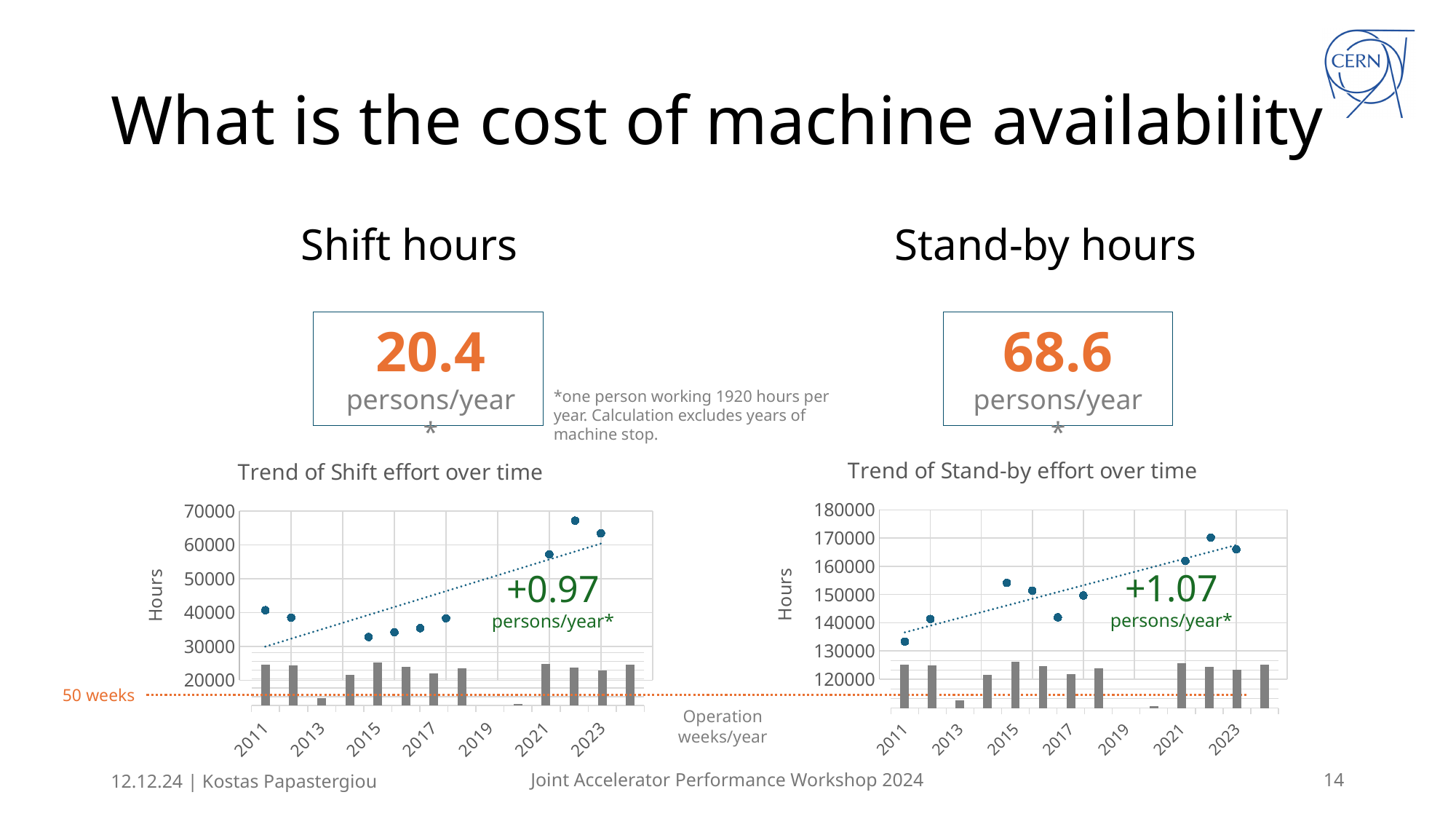
On the 'Trend of Shift effort over time' chart, do the plotted hours generally rise or fall from 2011 to 2023? rise On the 'Trend of Stand-by effort over time' chart, which year has the highest plotted hours value? 2023 On the 'Trend of Shift effort over time' chart, what slope value is annotated in green next to the trend line? +0.97 persons/year* On the 'Trend of Stand-by effort over time' chart, what slope value is annotated in green next to the trend line? +1.07 persons/year* On the 'Trend of Shift effort over time' chart, how many data points (dots) are plotted for hours? 9 On the 'Trend of Stand-by effort over time' chart, is the hours value for 2022 greater or less than 160000? greater On the 'Trend of Stand-by effort over time' chart, which year has the lowest plotted hours value? 2011 On the 'Trend of Stand-by effort over time' chart, is the hours value for 2011 greater or less than 140000? less On the 'Trend of Shift effort over time' chart, is the hours value for 2015 greater or less than 40000? less On the 'Trend of Stand-by effort over time' chart, do the plotted hours generally rise or fall from 2011 to 2023? rise On the 'Trend of Shift effort over time' chart, which year has the highest plotted hours value? 2023